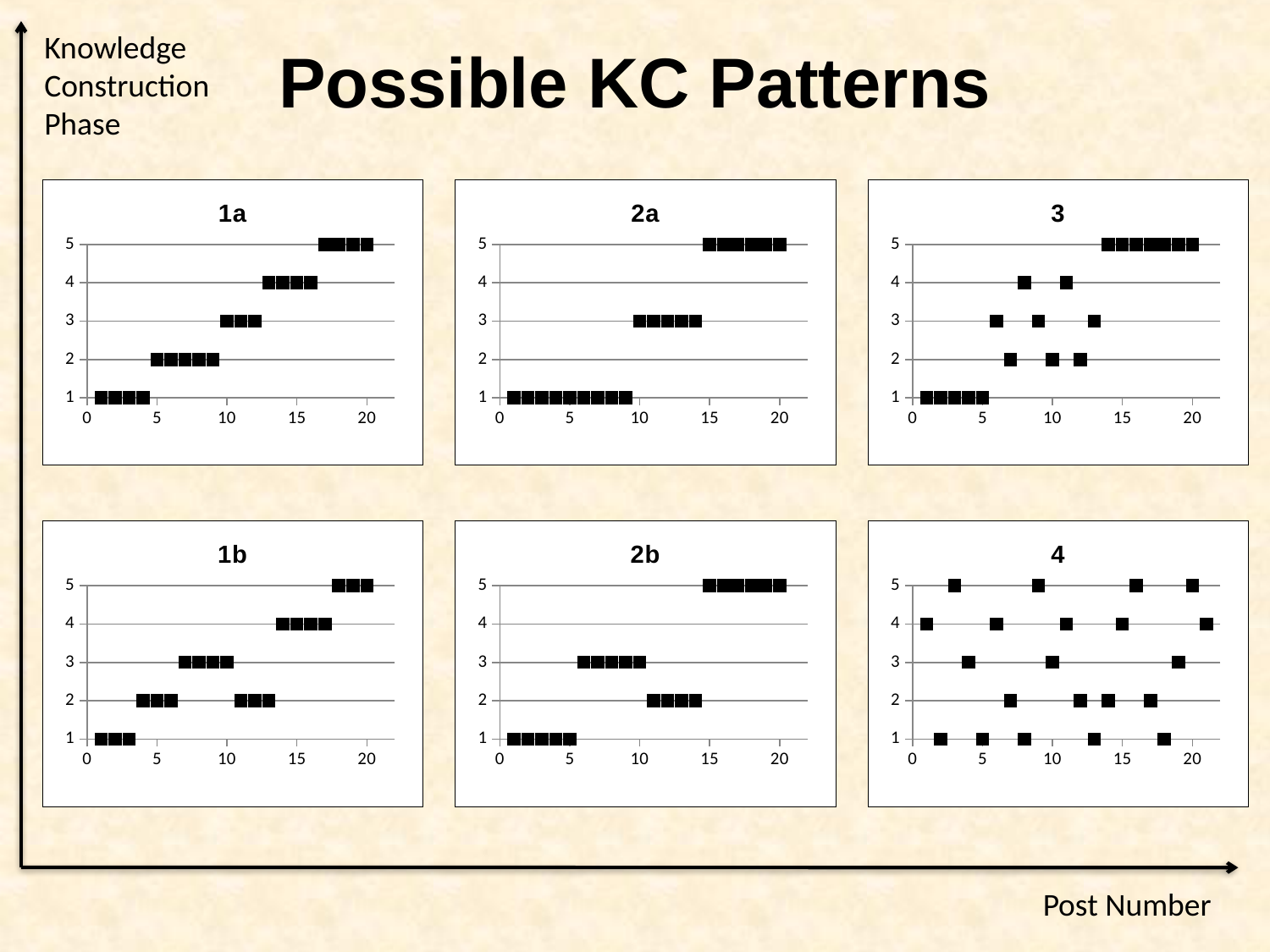
In chart 2b, which phase do the points move to after the group at phase 3? 2 How many charts are shown on the slide? 6 In chart 2a, is the value at post 20 greater or less than 3? greater In chart 3, what is the highest phase reached by the points? 5 In chart 4, what is the phase of the first point (at post 1)? 4 What kind of chart is chart 1a? scatter chart In chart 1a, do the phase values rise or fall as the post number increases? rise In chart 2a, how many distinct phase levels have points plotted? 3 What is the label of the horizontal axis shared by all the charts on the slide? Post Number In chart 1a, what phase are the first points (around posts 1 to 4) at? 1 In chart 1a, what phase do the last points (around post 20) reach? 5 In chart 1b, which phase level has points in two separate groups? 2